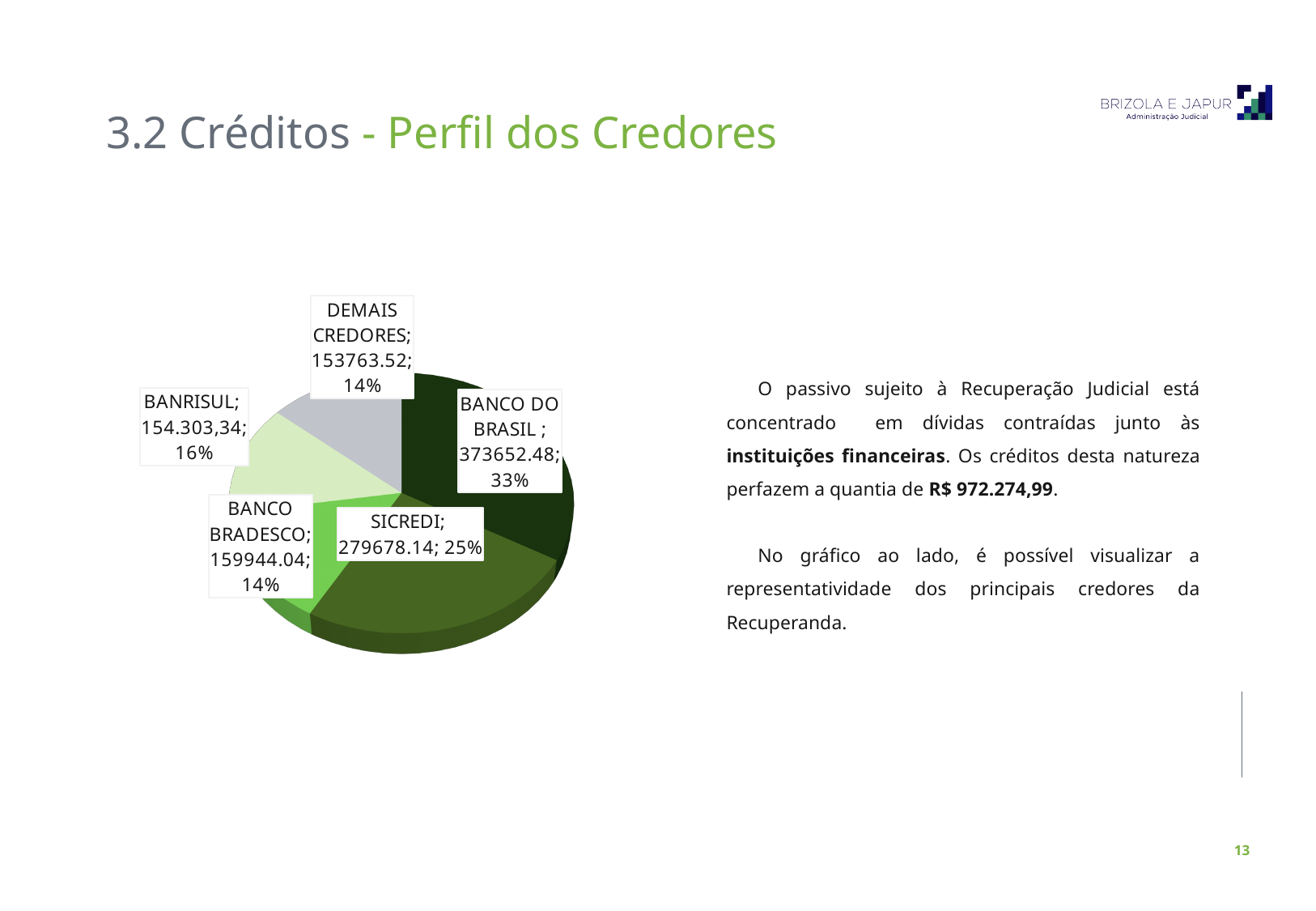
What percentage share does DEMAIS CREDORES have in the pie chart? 14% What is the value shown for SICREDI? 279678.14 What value is shown for BANRISUL? 154.303,34 What percentage share does SICREDI have in the pie chart? 25% Which creditor has the largest slice of the pie chart? BANCO DO BRASIL What percentage share does BANRISUL have in the pie chart? 16% What value is shown for BANCO BRADESCO? 159944.04 What is the difference between the values for BANCO DO BRASIL and SICREDI? 93974.34 How many slices does the pie chart have? 5 What value is shown for BANCO DO BRASIL? 373652.48 Which is larger, the value for SICREDI or the value for BANCO BRADESCO? SICREDI What kind of chart is shown on the slide? pie chart